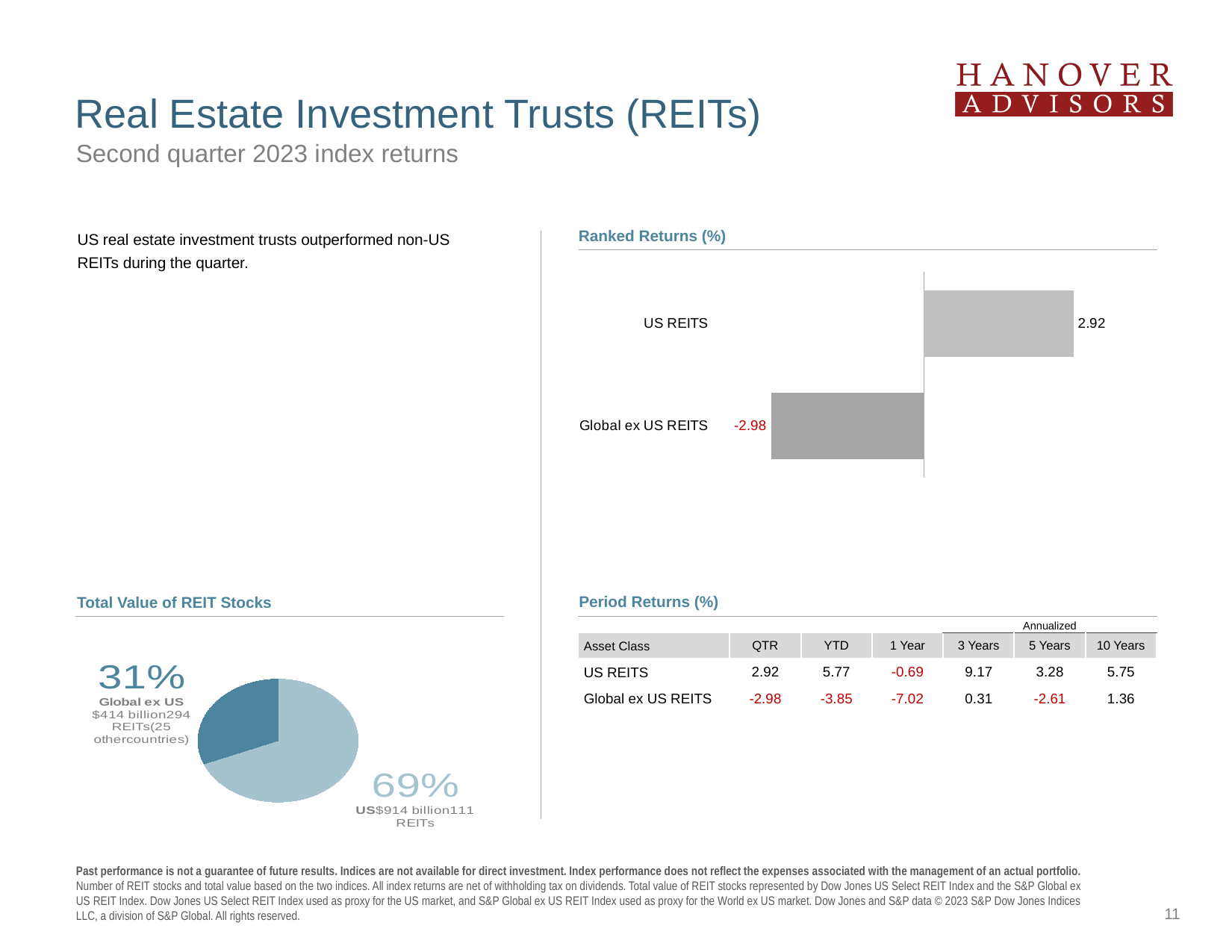
In the Ranked Returns (%) chart, which category has the lowest value? Global ex US REITS In the Ranked Returns (%) chart, what is the difference between the US REITS value and the Global ex US REITS value? 5.90 In the Ranked Returns (%) chart, how many categories are plotted? 2 What kind of chart is the Ranked Returns (%) chart? Bar chart In the Total Value of REIT Stocks chart, what share of the pie is Global ex US? 31% In the Total Value of REIT Stocks chart, what share of the pie is US? 69% In the Ranked Returns (%) chart, which is larger, the value for US REITS or the value for Global ex US REITS? US REITS In the Ranked Returns (%) chart, what is the value for Global ex US REITS? -2.98 In the Ranked Returns (%) chart, which category has the highest value? US REITS What kind of chart is the Total Value of REIT Stocks chart? Pie chart In the Ranked Returns (%) chart, what is the value for US REITS? 2.92 In the Total Value of REIT Stocks chart, what total value in dollars is shown for the US slice? $914 billion